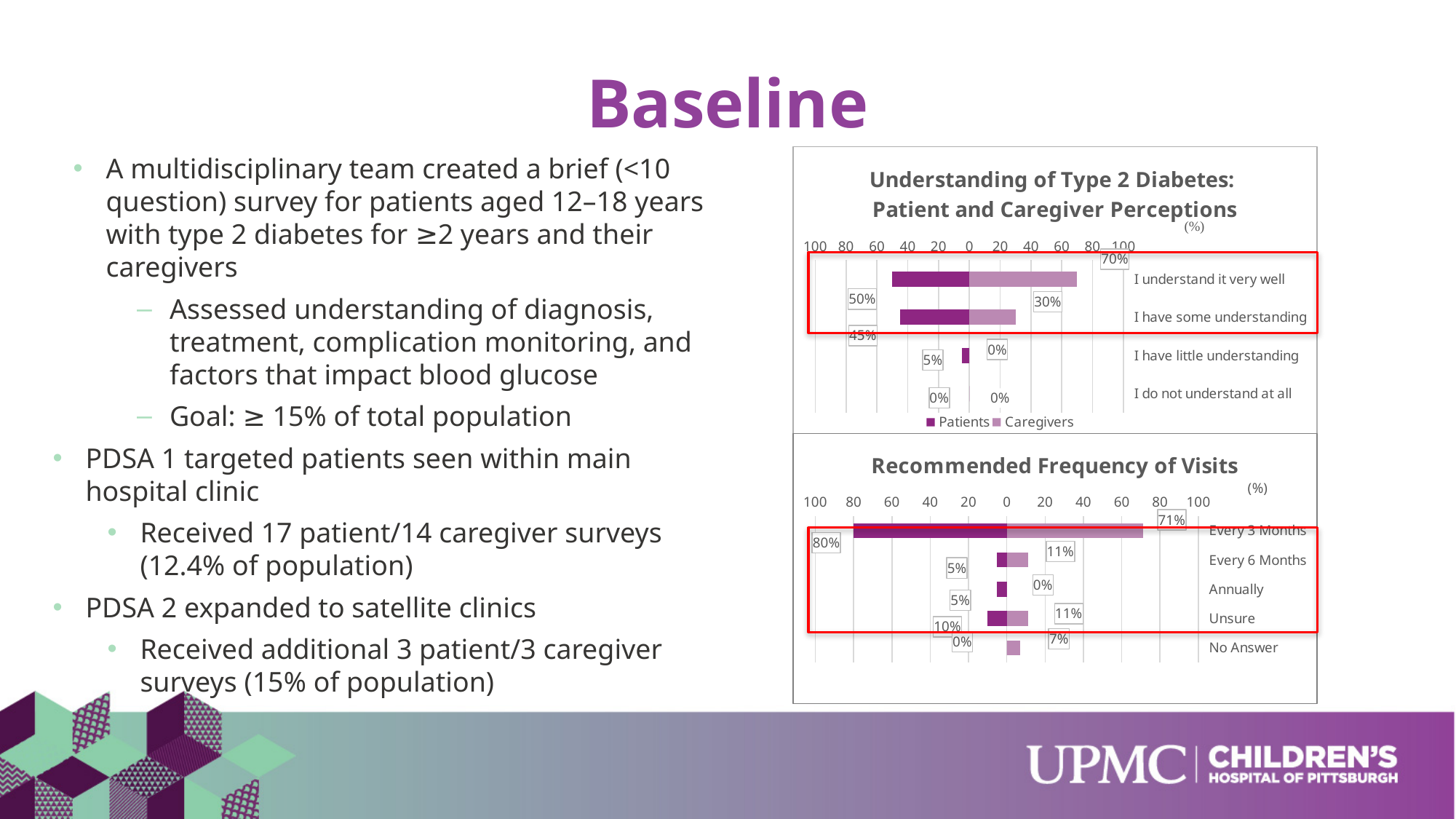
In the 'Recommended Frequency of Visits' chart, what percentage of patients chose 'Every 3 Months'? 80% In the 'Understanding of Type 2 Diabetes' chart, what is the difference between the caregiver and patient values for 'I understand it very well'? 20% In the 'Recommended Frequency of Visits' chart, what percentage of patients answered 'Unsure'? 10% In the 'Understanding of Type 2 Diabetes' chart, which response category has the highest value for patients? I understand it very well In the 'Understanding of Type 2 Diabetes' chart, what percentage of caregivers said 'I have some understanding'? 30% In the 'Understanding of Type 2 Diabetes' chart, how many series does the legend list? 2 In the 'Recommended Frequency of Visits' chart, what percentage of caregivers chose 'Every 3 Months'? 71% What type of chart is the 'Recommended Frequency of Visits' chart? Bar chart In the 'Understanding of Type 2 Diabetes' chart, what percentage of caregivers said 'I understand it very well'? 70% In the 'Understanding of Type 2 Diabetes' chart, what percentage of patients said 'I understand it very well'? 50% In the 'Recommended Frequency of Visits' chart, how many response categories are shown? 5 In the 'Recommended Frequency of Visits' chart, which is larger for 'Every 6 Months': the patient value or the caregiver value? Caregiver value